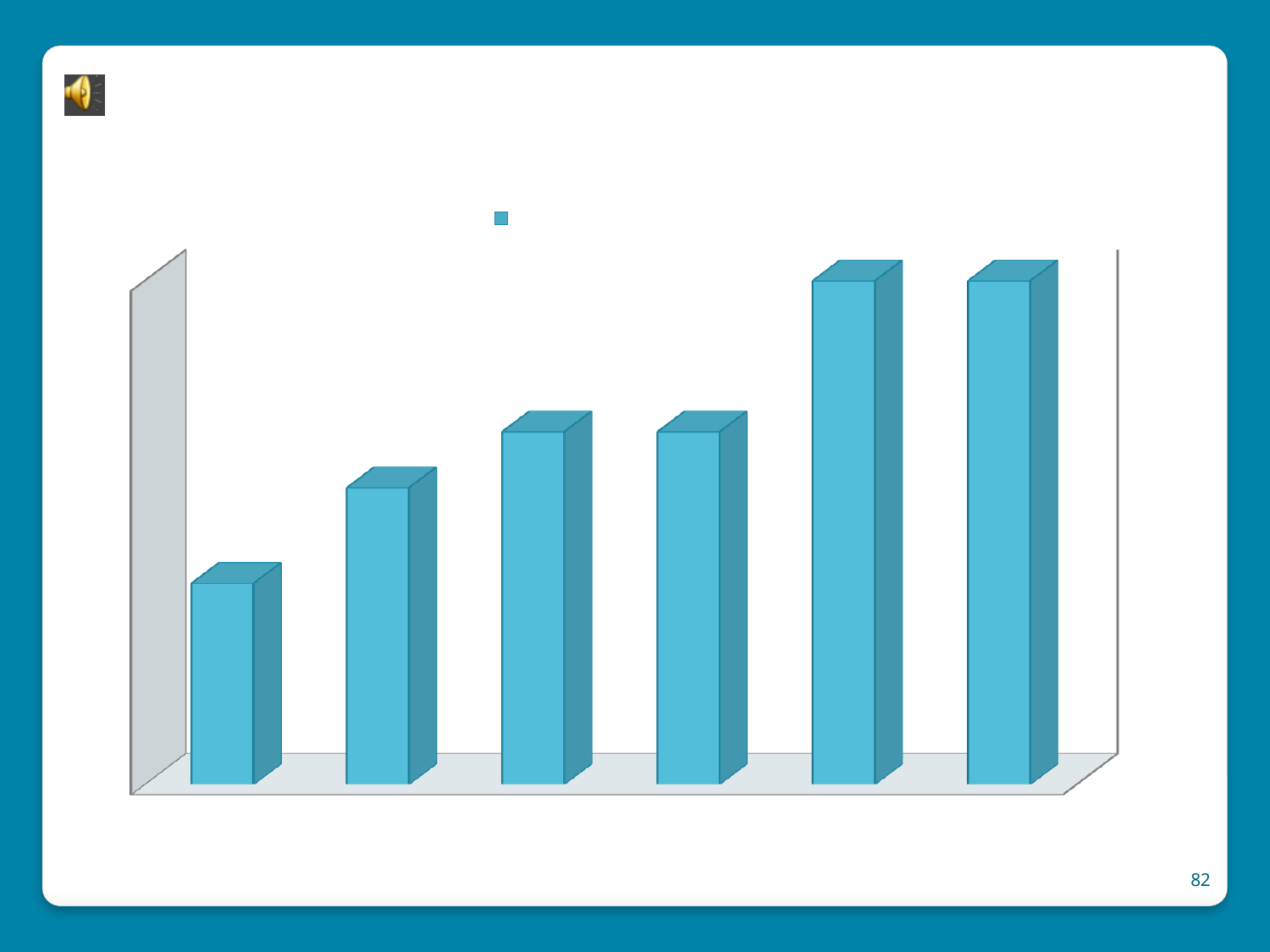
Is the fourth bar from the left taller or shorter than the sixth bar? shorter How many bars are plotted in the chart? 6 Do the bars generally rise or fall from left to right across the chart? rise How many series does the legend list? 1 Is the second bar from the left taller or shorter than the fifth bar? shorter Which bar is the shortest, counting from the left? the first bar Are the bars in the chart vertical or horizontal? vertical Is the first bar from the left taller or shorter than the second bar? shorter What colour are the bars in the chart? blue What kind of chart is shown on the slide? bar chart